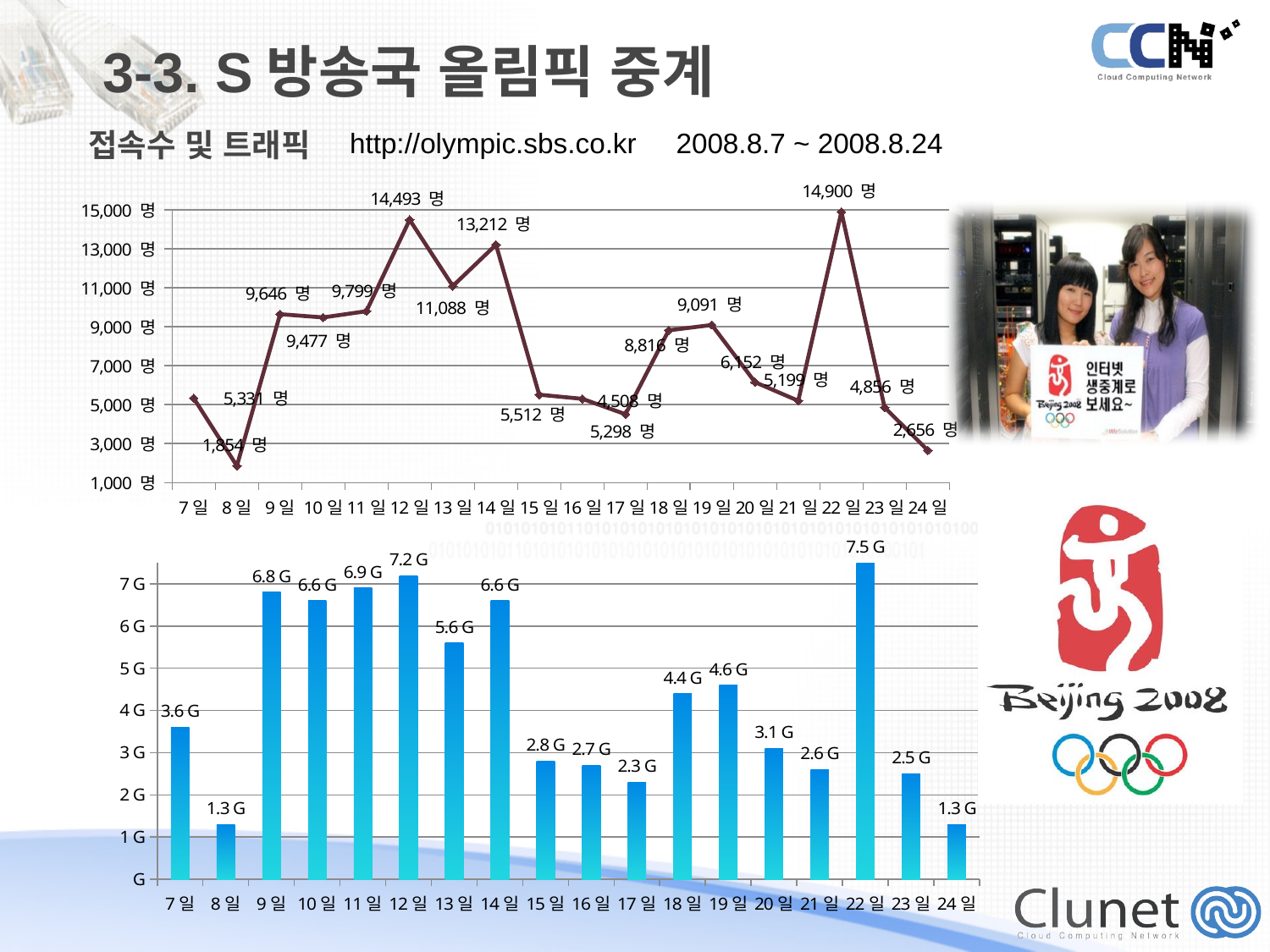
In the bottom bar chart, which day has the highest traffic? 22일 In the top line chart, what is the value for 14일? 13,212 명 In the top line chart, what is the difference between the values for 22일 and 12일? 407 명 In the top line chart, how many visitors are recorded for 12일? 14,493 명 What kind of chart is the bottom chart? Bar chart In the top line chart, which day has the lowest number of visitors? 8일 In the bottom bar chart, which is larger, the traffic on 9일 or on 13일? 9일 In the bottom bar chart, what is the traffic value for 7일? 3.6 G In the bottom bar chart, what is the difference between the traffic on 22일 and 7일? 3.9 G What kind of chart is the top chart? Line chart In the top line chart, which day has the highest number of visitors? 22일 How many days are shown on the x axis of the bottom bar chart? 18